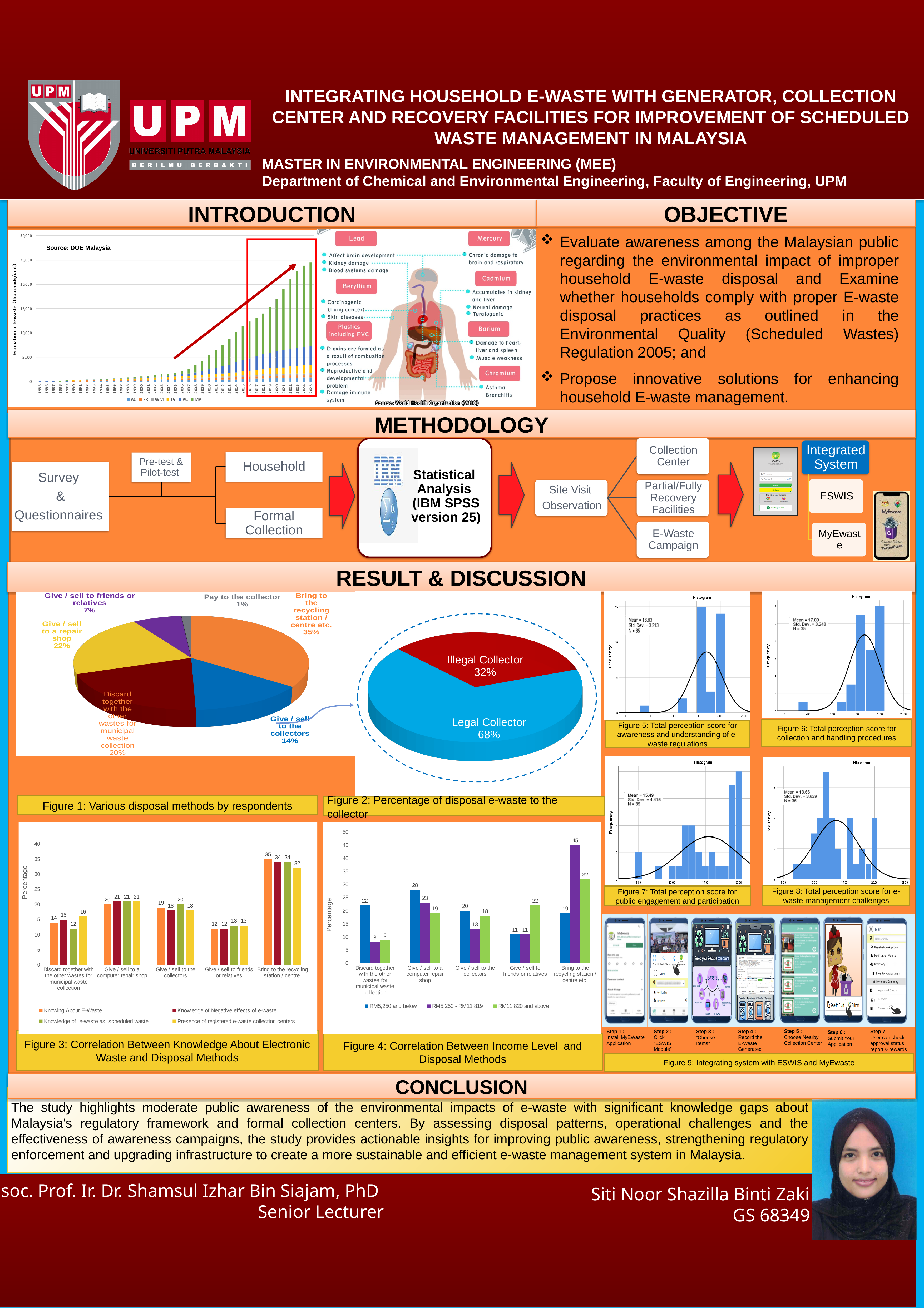
In Figure 2 (Percentage of disposal e-waste to the collector), what is the difference between the Legal Collector and Illegal Collector shares? 36% How many series does the legend of Figure 3 (Correlation Between Knowledge About Electronic Waste and Disposal Methods) list? 4 In Figure 4 (Correlation Between Income Level and Disposal Methods), what is the difference between 'RM5,250 and below' and 'RM5,250 - RM11,819' for 'Discard together with the other wastes for municipal waste collection'? 14 In Figure 3 (Correlation Between Knowledge About Electronic Waste and Disposal Methods), what is the value of 'Knowing About E-Waste' for 'Bring to the recycling station / centre'? 35 What kind of chart is Figure 2 (Percentage of disposal e-waste to the collector)? Pie chart How many disposal method categories are shown on the x axis of Figure 4 (Correlation Between Income Level and Disposal Methods)? 5 In Figure 1 (Various disposal methods by respondents), what share of respondents give / sell to a repair shop? 22% In Figure 3 (Correlation Between Knowledge About Electronic Waste and Disposal Methods), which disposal method has the highest values across all series? Bring to the recycling station / centre In Figure 1 (Various disposal methods by respondents), what share of respondents bring e-waste to the recycling station / centre? 35% In Figure 1 (Various disposal methods by respondents), which disposal method has the smallest share? Pay to the collector In Figure 4 (Correlation Between Income Level and Disposal Methods), what is the value for 'RM5,250 - RM11,819' at 'Bring to the recycling station / centre etc.'? 45 In Figure 2 (Percentage of disposal e-waste to the collector), what percentage goes to the Legal Collector? 68%